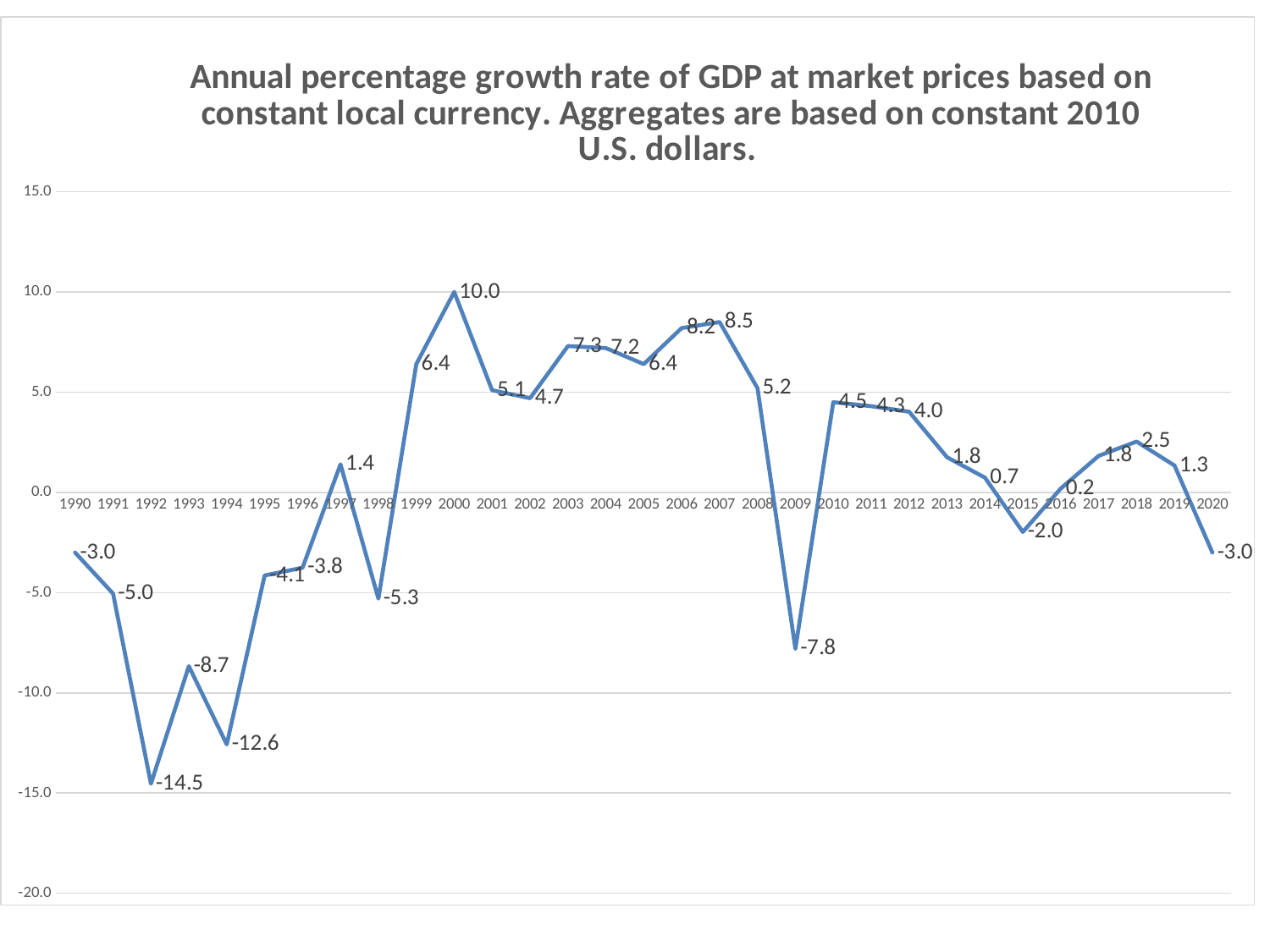
Which is larger, the value for 2006 or the value for 2010? 2006 What kind of chart is shown? line chart Do the values rise or fall from 2018 to 2020? fall What is the value for 2000? 10.0 What is the value for 2009? -7.8 Is the value for 1994 greater or less than -10.0? less Which year has the highest value? 2000 What is the difference between the values for 2007 and 2008? 3.3 What is the difference between the values for 1992 and 1993? 5.8 What is the value for 2020? -3.0 How many years are plotted on the chart? 31 Which year has the lowest value? 1992